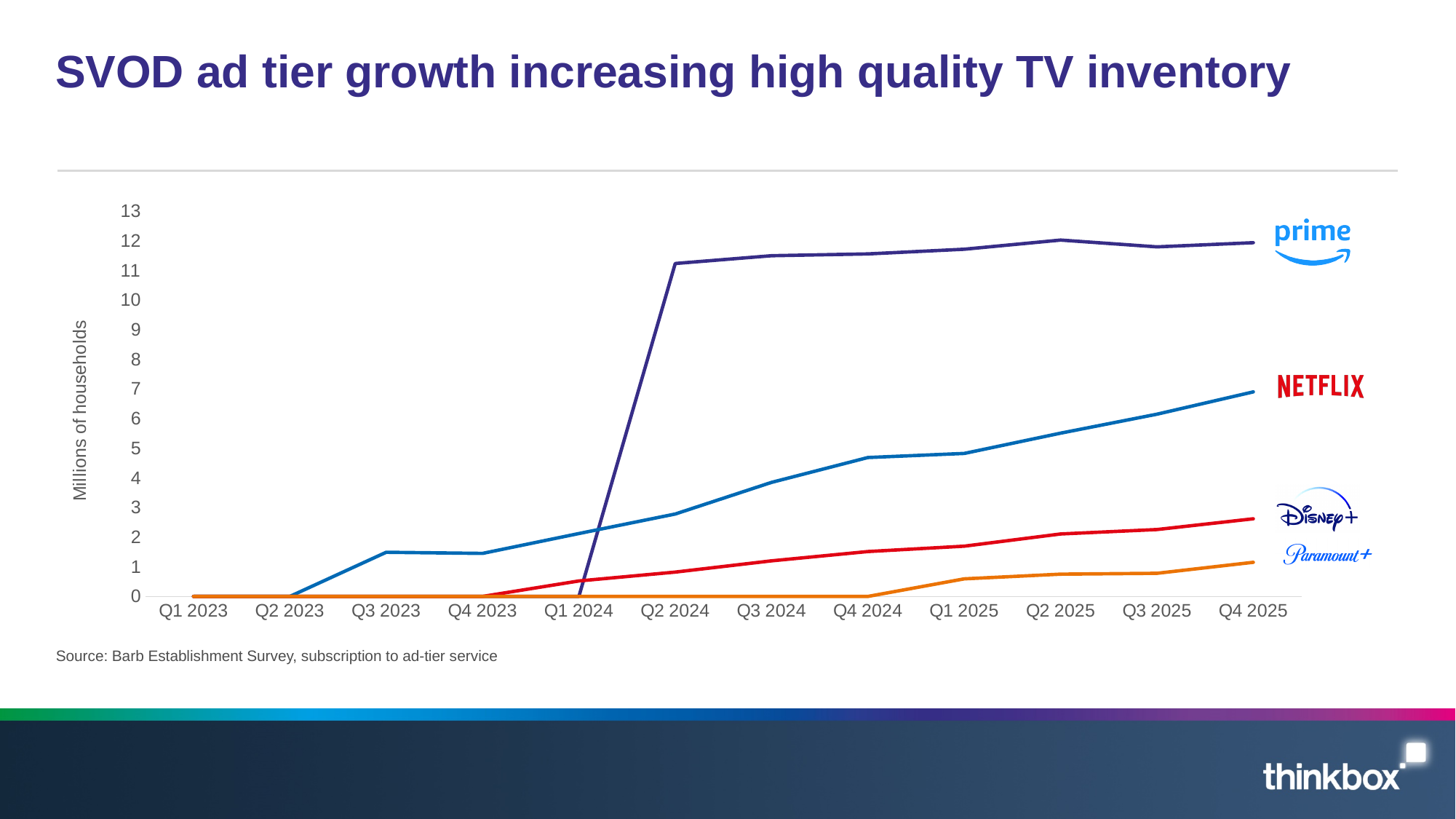
Is the value for Paramount+ in Q4 2025 greater or less than 2? less Is the value for Netflix in Q4 2025 greater or less than 6? greater How many services (series) are shown on the chart? 4 What kind of chart is shown on the slide? Line chart What is the label on the y axis? Millions of households Which service has the highest value in Q4 2025? Prime Which service has the lowest value in Q4 2025? Paramount+ How many quarters are plotted along the x axis? 12 In Q4 2025, which is larger: the value for Netflix or the value for Disney+? Netflix Is the value for Prime in Q4 2025 greater or less than 11? greater What is the value for Prime in Q1 2024? 0 What is the value for Netflix in Q1 2023? 0